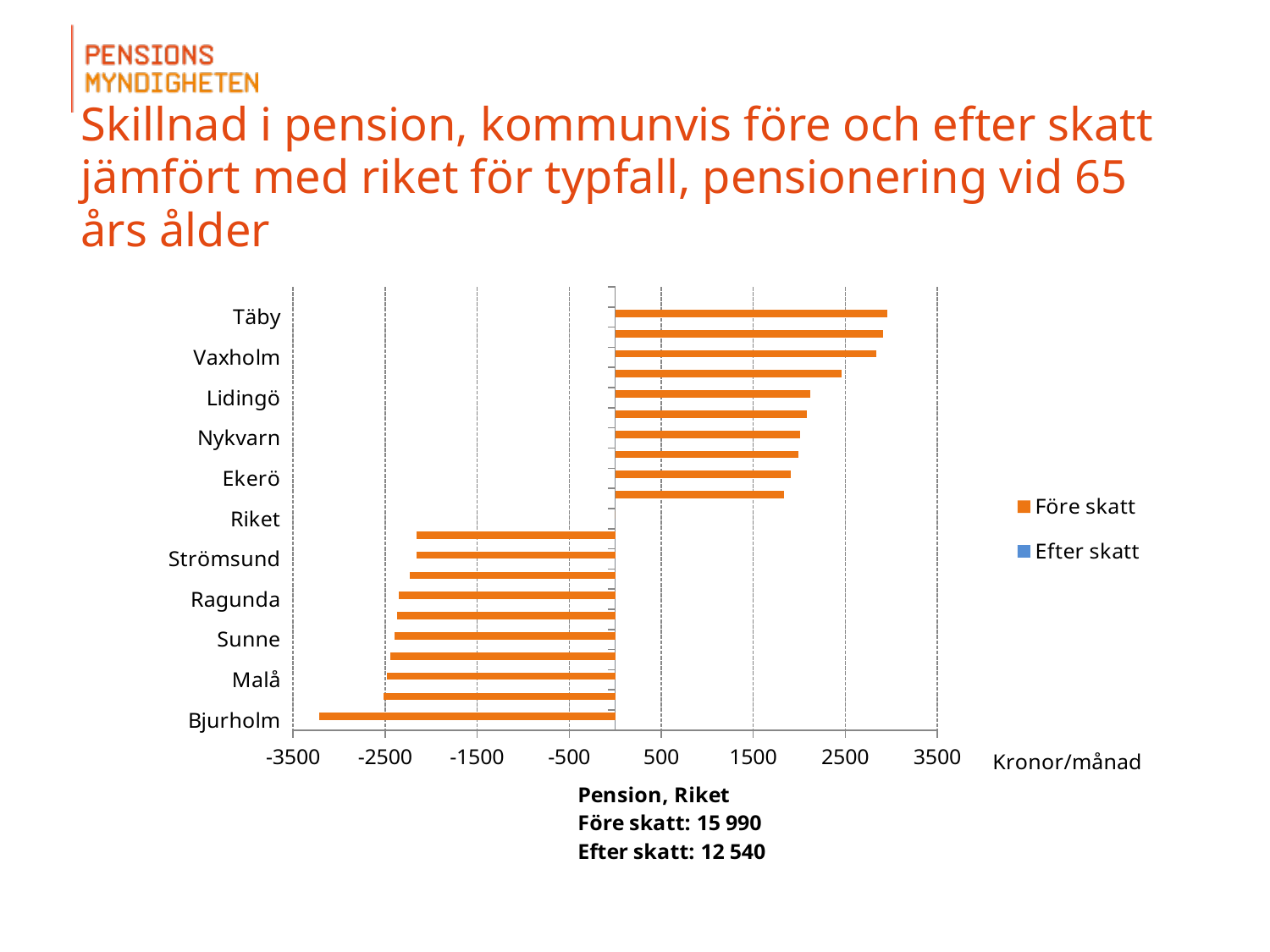
How many series does the legend list? 2 What kind of chart is shown on the slide? bar chart Is the value for Ekerö greater or less than 1500? greater Which category has the lowest (most negative) value? Bjurholm According to the note below the chart, what is the pension before tax (Före skatt) for Riket? 15 990 Is the value for Täby greater or less than 2500? greater Is the value for Bjurholm greater or less than -2500? less Which category has the highest (most positive) value? Täby What unit is given for the horizontal axis? Kronor/månad Which is larger, the value for Lidingö or the value for Ekerö? Lidingö Which is larger, the value for Täby or the value for Vaxholm? Täby